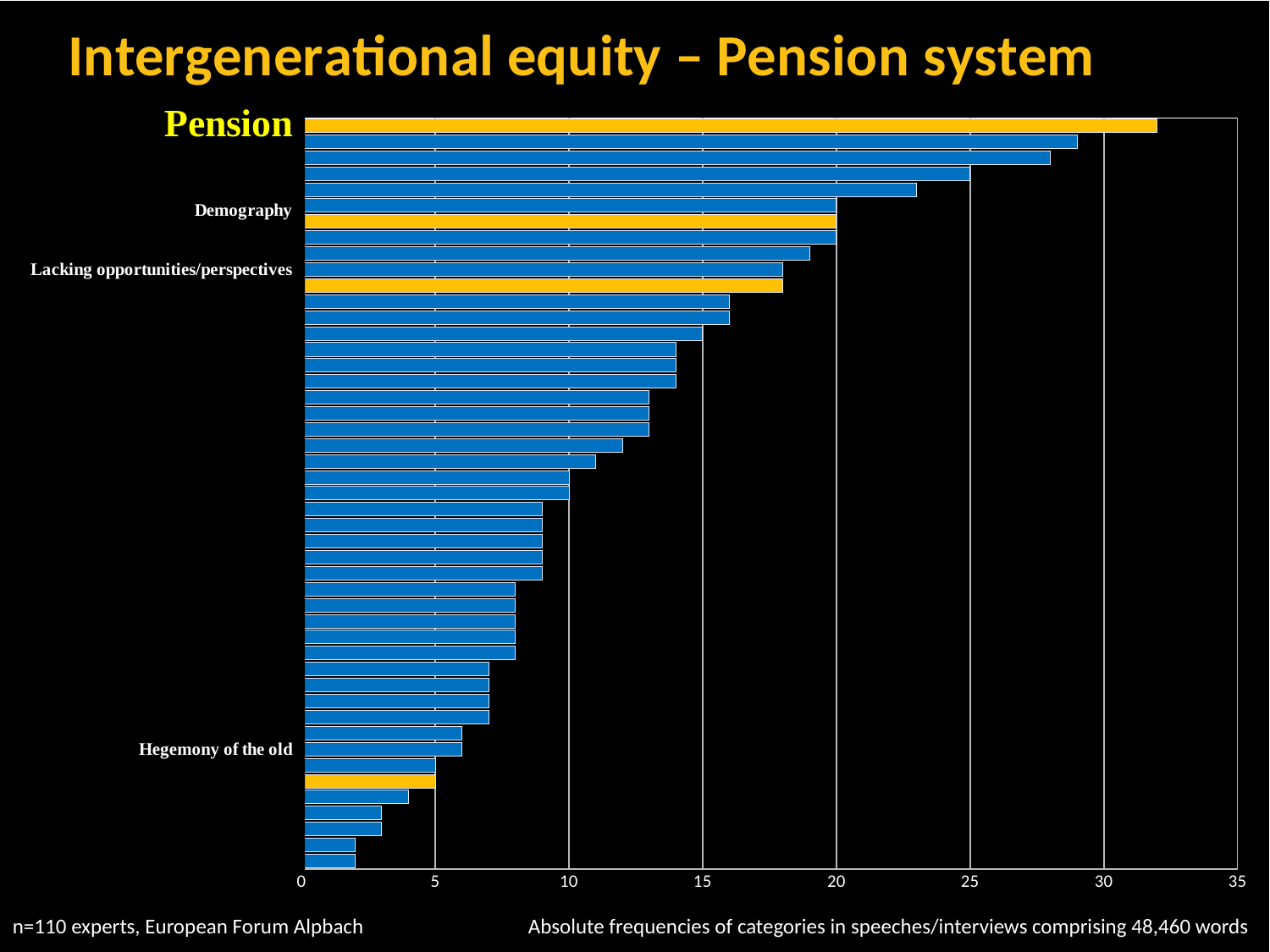
What is the value for Demography? 20 Which is larger, the value for Pension or the value for Demography? Pension Is the value for Lacking opportunities/perspectives greater or less than 15? greater Is the value for Pension greater or less than 30? greater What is the difference between the values for Demography and Hegemony of the old? 15 Which labelled category has the highest value? Pension What is the highest value shown on the horizontal axis? 35 What is the value for Hegemony of the old? 5 What kind of chart is shown on the slide? bar chart Which is larger, the value for Demography or the value for Lacking opportunities/perspectives? Demography Is the value for Lacking opportunities/perspectives greater or less than 20? less Which labelled category has the lowest value? Hegemony of the old